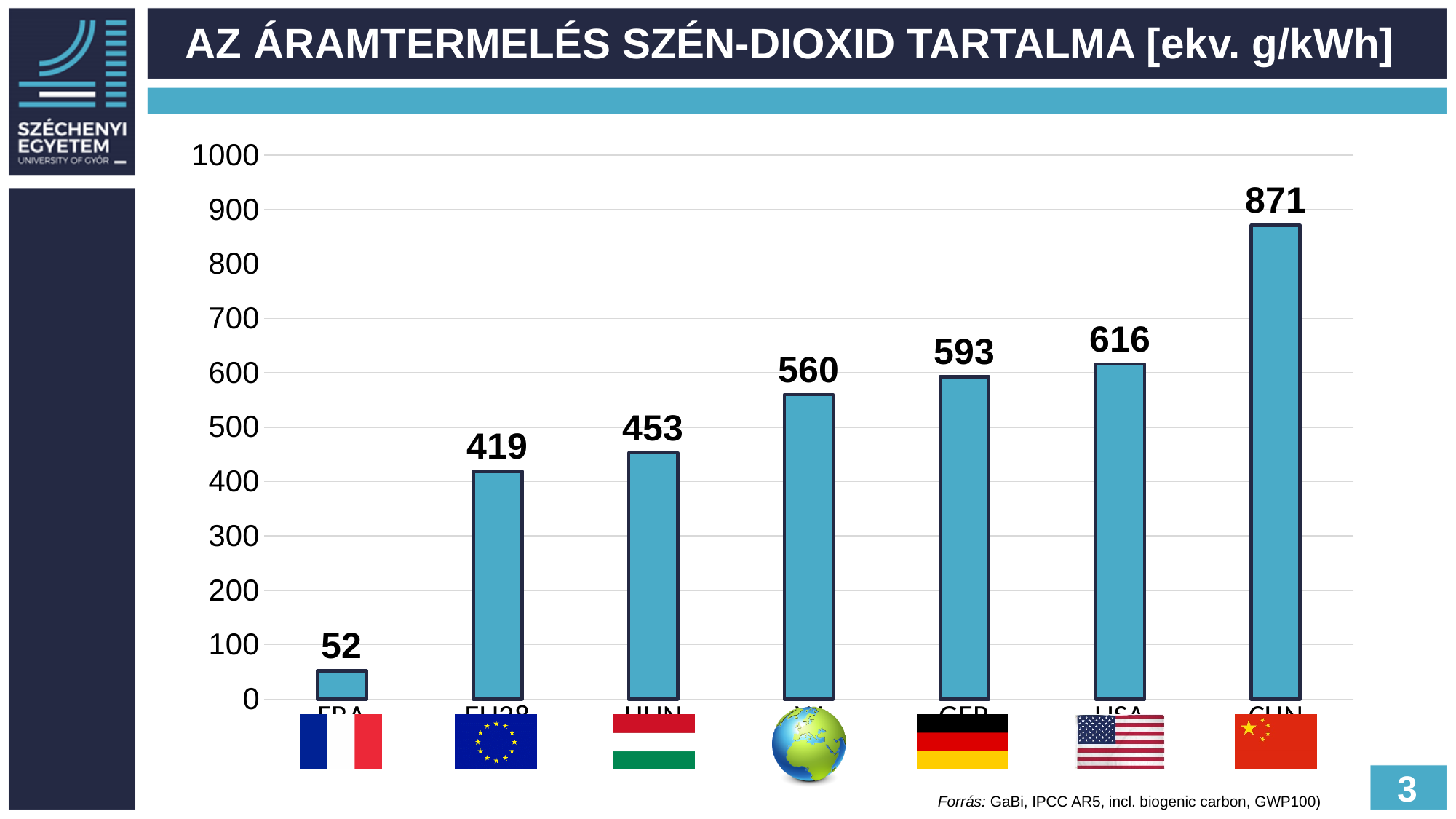
What is the value for HUN? 453 What is the value for CHN? 871 What is the difference between the values for CHN and FRA? 819 What is the difference between the values for USA and GER? 23 What is the value for USA? 616 How many bars are shown in the chart? 7 What kind of chart is shown on the slide? Bar chart What is the value for FRA? 52 Which is larger, the value for EU28 or the value for HUN? HUN Which category has the lowest value? FRA What is the title of the chart on the slide? AZ ÁRAMTERMELÉS SZÉN-DIOXID TARTALMA [ekv. g/kWh] Which category has the highest value? CHN